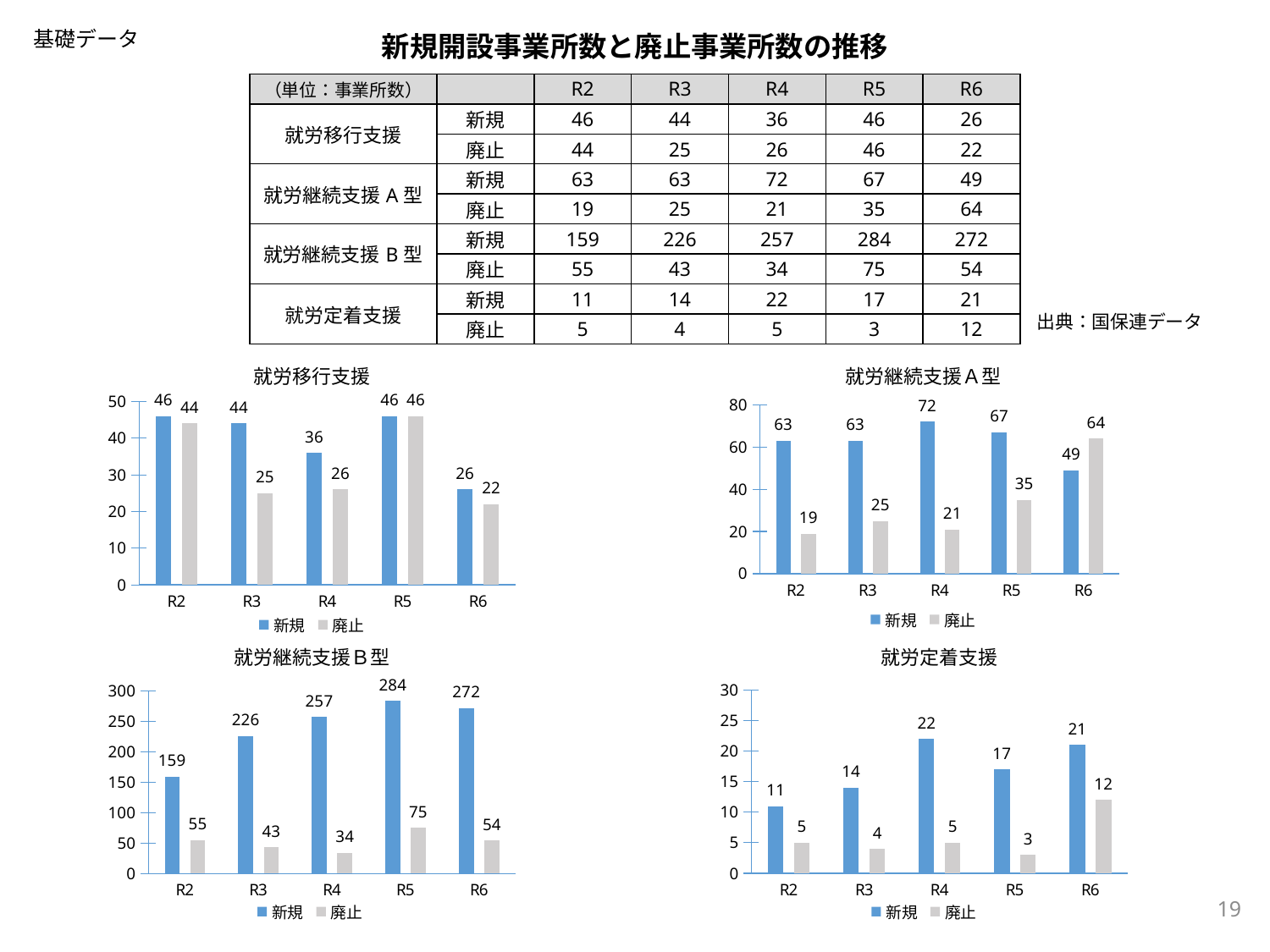
In the 就労継続支援B型 chart, does the 新規 value rise or fall from R2 to R5? rise What type of chart is the 就労継続支援B型 chart? bar chart What is the title of the chart in the top-right position of the slide? 就労継続支援A型 In the 就労継続支援B型 chart, what is the difference between 新規 and 廃止 for R4? 223 In the 就労継続支援A型 chart, which is larger for R6, 新規 or 廃止? 廃止 In the 就労継続支援A型 chart, what is the value of 廃止 for R6? 64 In the 就労継続支援B型 chart, which year has the highest 新規 value? R5 In the 就労移行支援 chart, how many years are shown on the x axis? 5 In the 就労定着支援 chart, which year has the lowest 廃止 value? R5 In the 就労定着支援 chart, what is the difference between 新規 and 廃止 for R6? 9 In the 就労移行支援 chart, what is the value of 新規 for R4? 36 In the 就労定着支援 chart, how many series does the legend list? 2